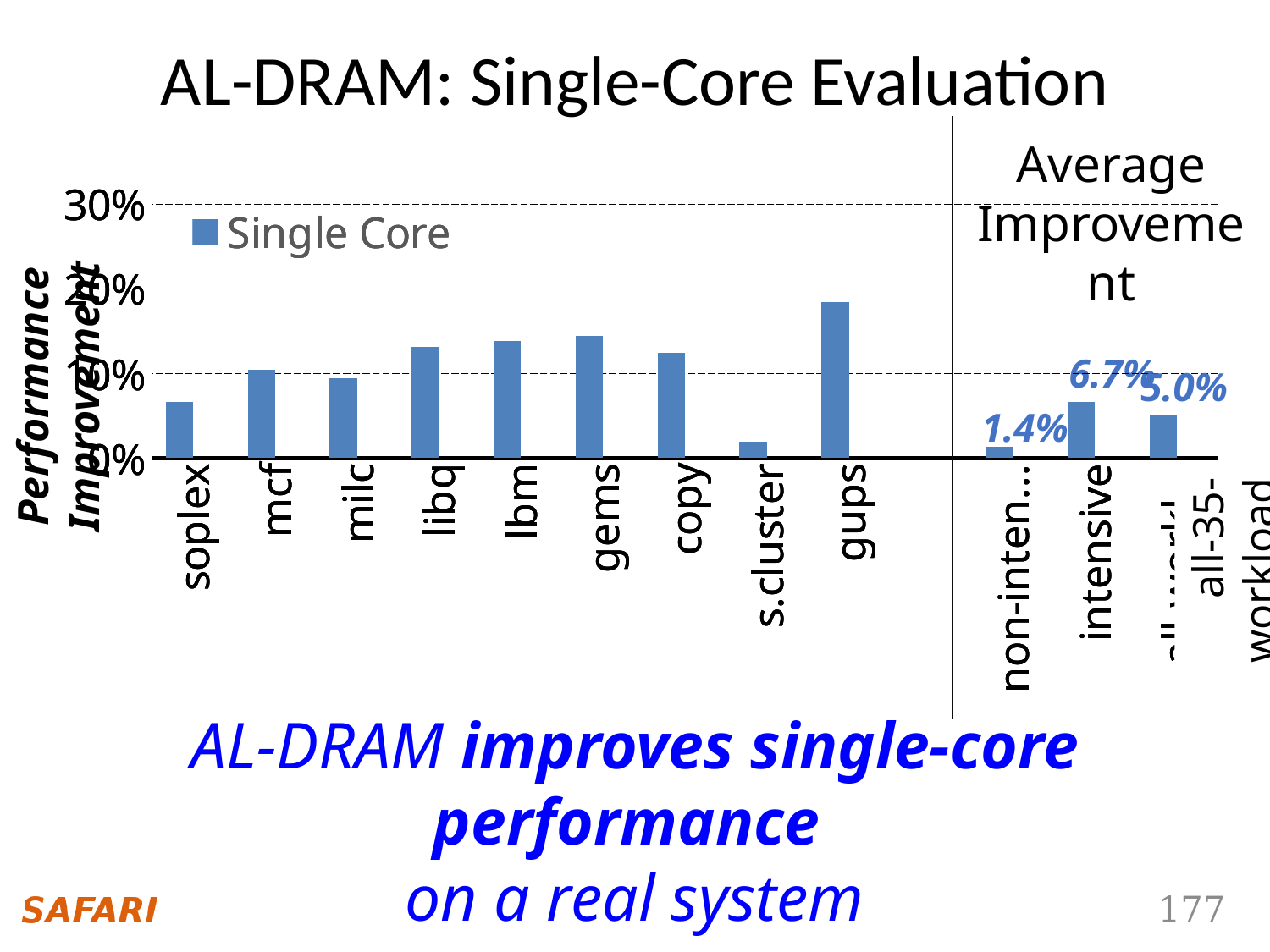
Which is larger, the value for gups or the value for soplex? gups What is the value for the all-35-workload category? 5.0% Is the value for soplex greater or less than 10%? less What kind of chart is shown on the slide? bar chart How many series does the legend list? 1 What is the value for the non-intensive category? 1.4% What is the value for the intensive category? 6.7% What is the name of the series shown in the legend? Single Core Which workload has the highest performance improvement? gups Is the value for gups greater or less than 10%? greater What is the difference between the intensive and non-intensive values? 5.3% Which is larger, the value for intensive or the value for non-intensive? intensive